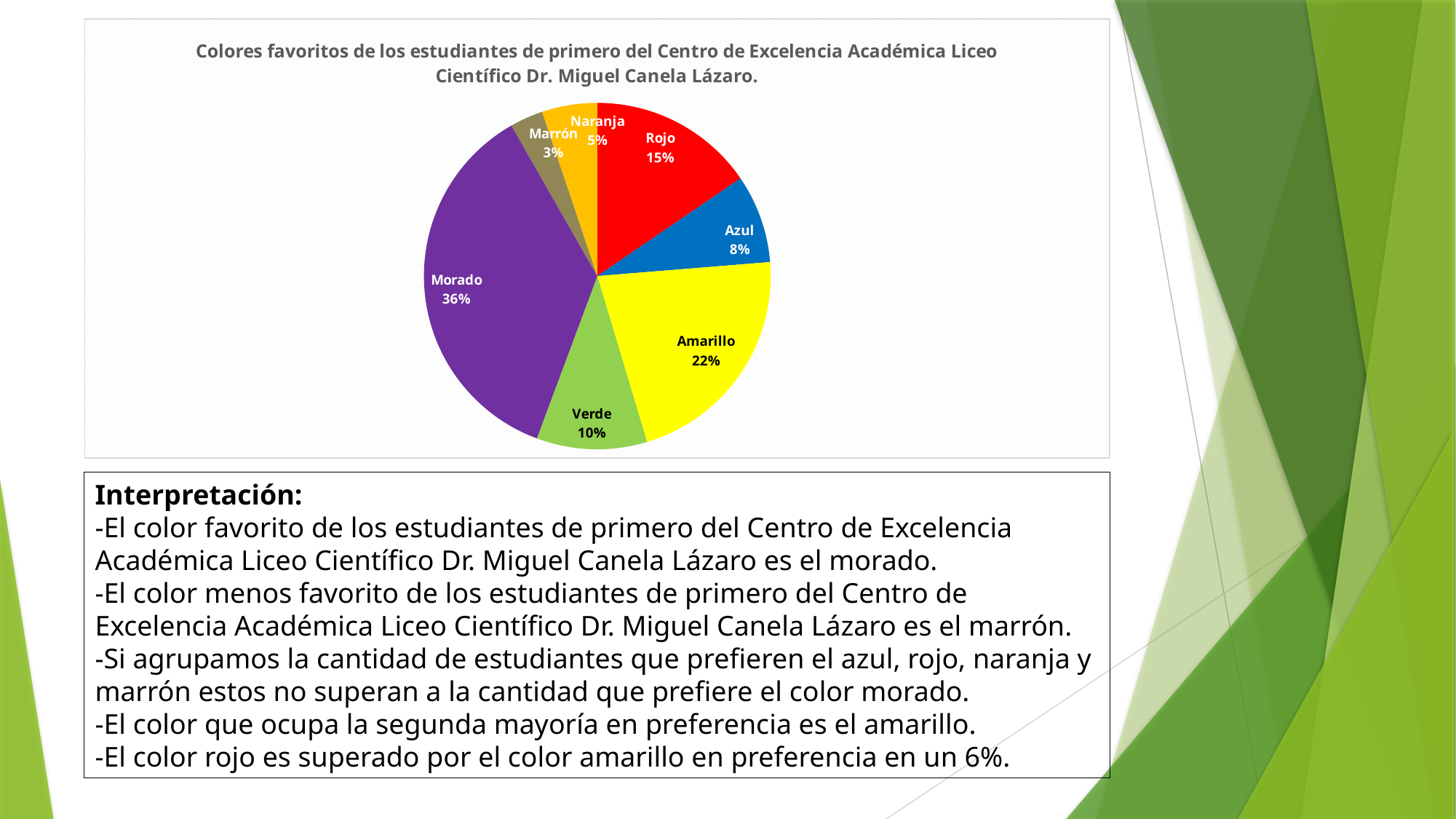
What is the difference between the Amarillo and Rojo percentages? 7% Which is larger, the share for Verde or the share for Naranja? Verde Which colour has the largest slice of the pie? Morado Which colour has the smallest slice of the pie? Marrón What is the value shown for Azul? 8% What share of the pie does Morado have? 36% How many colour categories are shown in the pie chart? 7 What is the value shown for Rojo? 15% What colour is used for the Morado slice in the chart? Purple What kind of chart is shown on the slide? Pie chart What is the value shown for Amarillo? 22% What is the combined share of Azul, Rojo, Naranja and Marrón? 31%